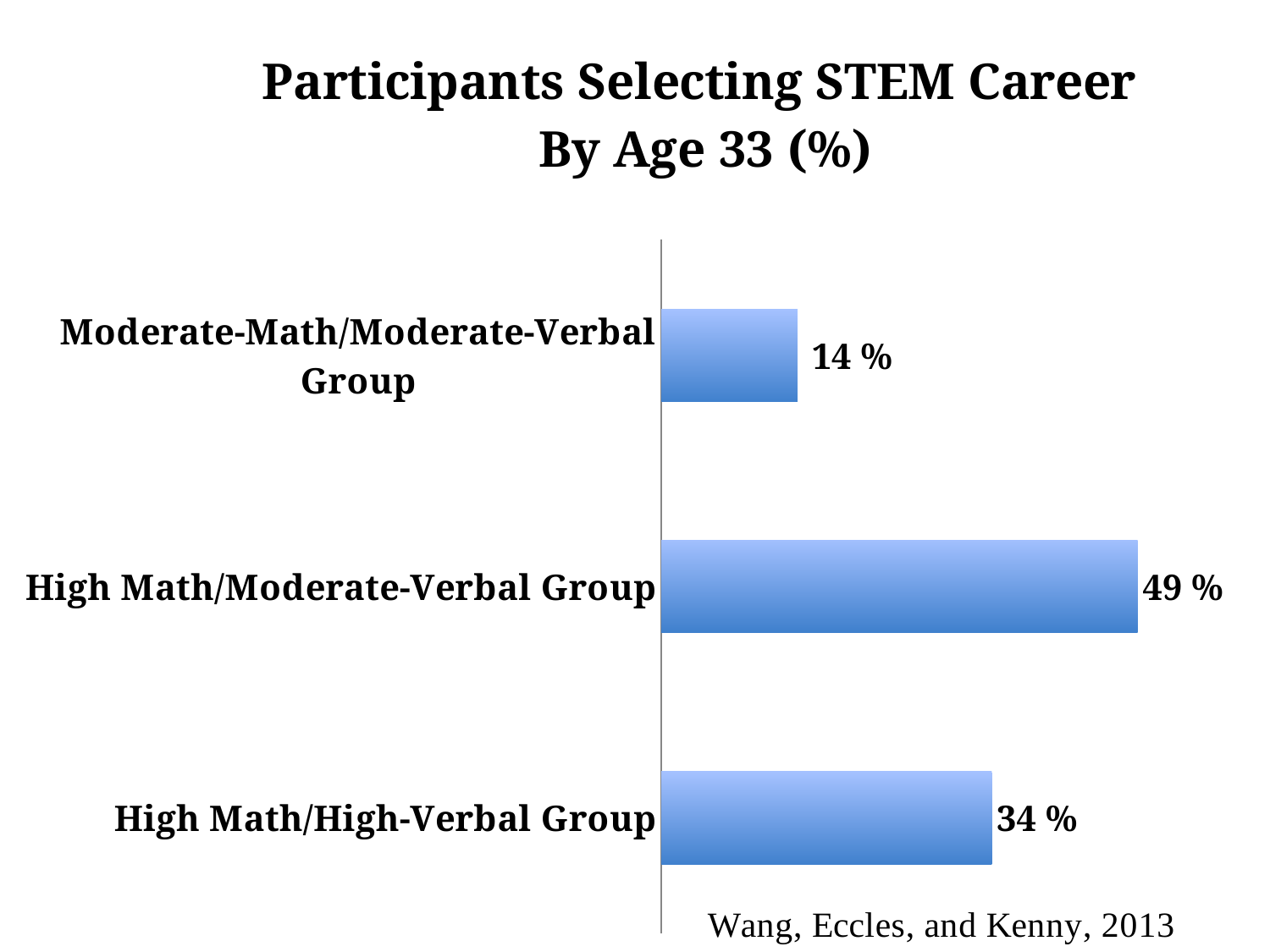
Which group has the lowest percentage of participants selecting a STEM career? Moderate-Math/Moderate-Verbal Group Which group has a larger percentage selecting a STEM career: the High Math/High-Verbal Group or the Moderate-Math/Moderate-Verbal Group? High Math/High-Verbal Group What percentage of the High Math/High-Verbal Group selected a STEM career by age 33? 34 % Which group has the highest percentage of participants selecting a STEM career? High Math/Moderate-Verbal Group What percentage of the High Math/Moderate-Verbal Group selected a STEM career by age 33? 49 % What is the title of the chart? Participants Selecting STEM Career By Age 33 (%) What is the difference in percentage points between the High Math/Moderate-Verbal Group and the High Math/High-Verbal Group? 15 What is the difference in percentage points between the High Math/High-Verbal Group and the Moderate-Math/Moderate-Verbal Group? 20 What percentage of the Moderate-Math/Moderate-Verbal Group selected a STEM career by age 33? 14 % What type of chart is shown on the slide? Bar chart What source is cited for the chart data? Wang, Eccles, and Kenny, 2013 How many groups are shown in the chart? 3